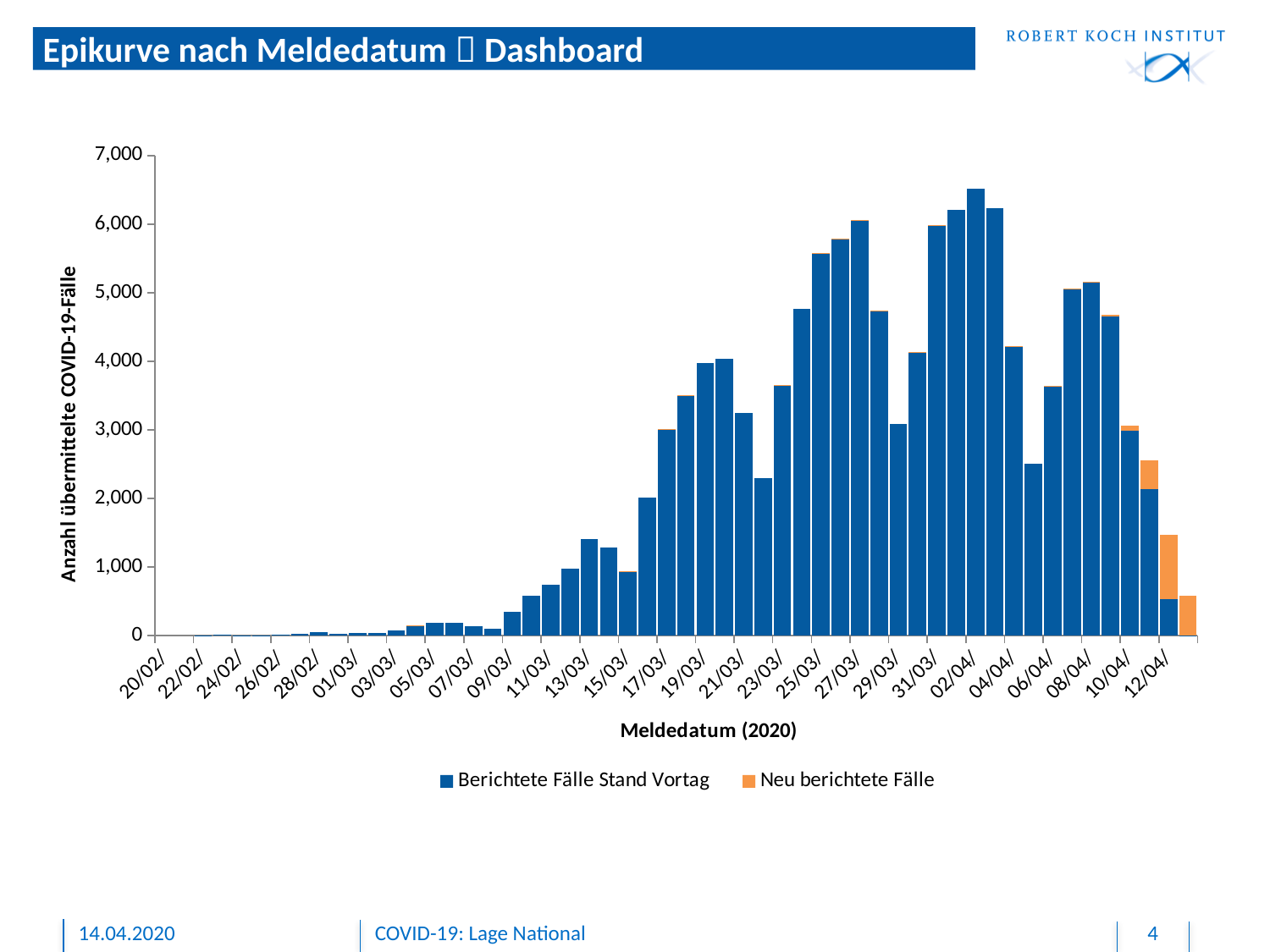
Is the total value for 13/03 greater or less than 1,000? greater What is the label of the y axis? Anzahl übermittelte COVID-19-Fälle Do the values generally rise or fall from 20/02 to 02/04? rise Is the total value for 11/03 greater or less than 1,000? less Is the total value for 06/04 greater or less than 3,000? greater Which has the larger total bar, 25/03 or 29/03? 25/03 Which reporting date has the highest total bar? 02/04 What kind of chart is shown on the slide? bar chart What are the two series named in the legend? Berichtete Fälle Stand Vortag; Neu berichtete Fälle How many series does the legend list? 2